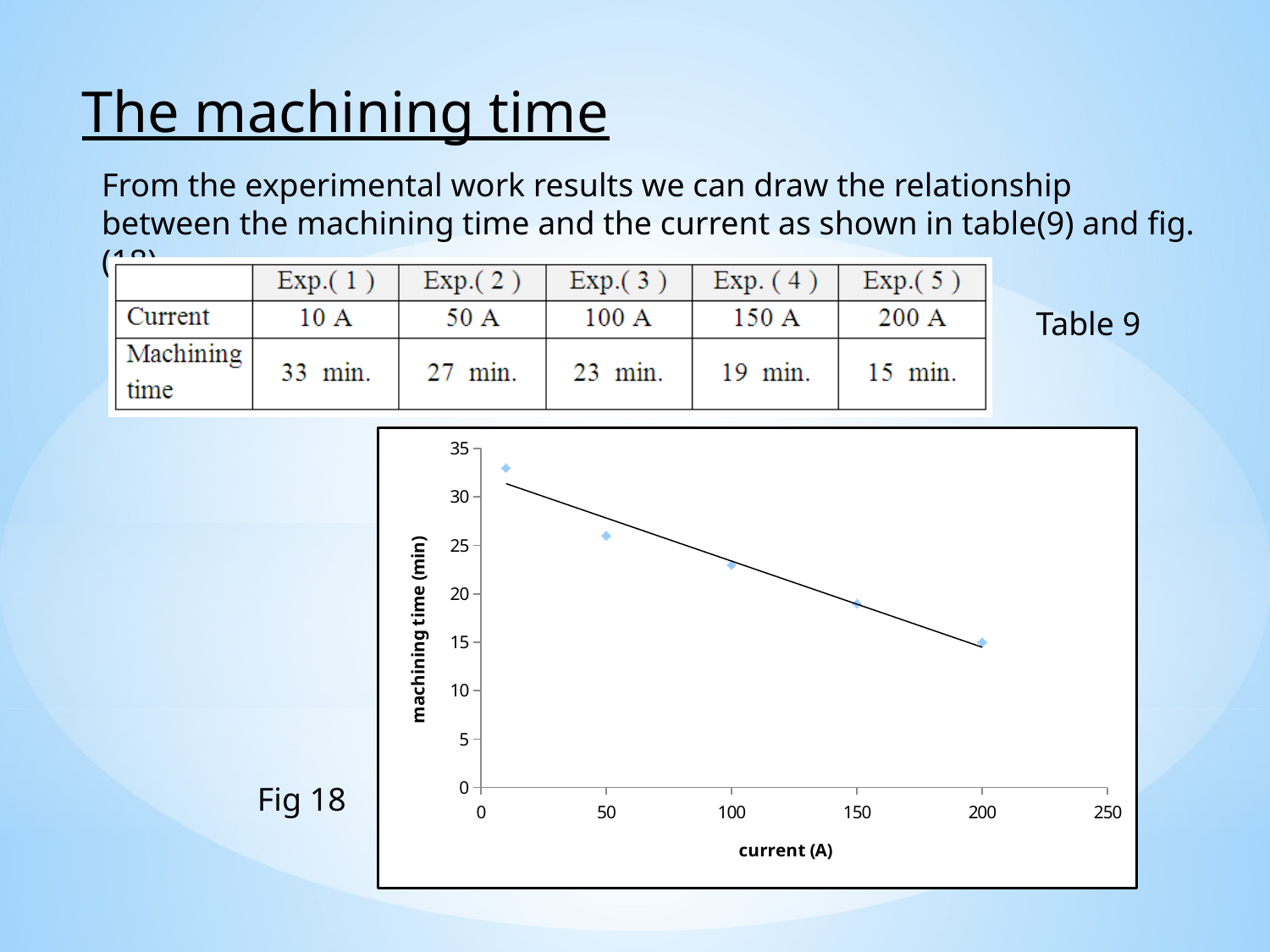
In Fig 18, is the machining time at 50 A greater or less than 25? greater In Fig 18, is the machining time at 10 A greater or less than 30? greater In Fig 18, does the machining time rise or fall as the current increases? fall In Fig 18, is the machining time at 100 A greater or less than 25? less What kind of chart is shown in Fig 18? scatter chart In Fig 18, what is the machining time at a current of 200 A? 15 What is the label on the vertical axis of Fig 18? machining time (min) How many data points are plotted in Fig 18? 5 In Fig 18, at which current is the machining time lowest? 200 A In Fig 18, which has the larger machining time: 50 A or 150 A? 50 A In Fig 18, at which current is the machining time highest? 10 A